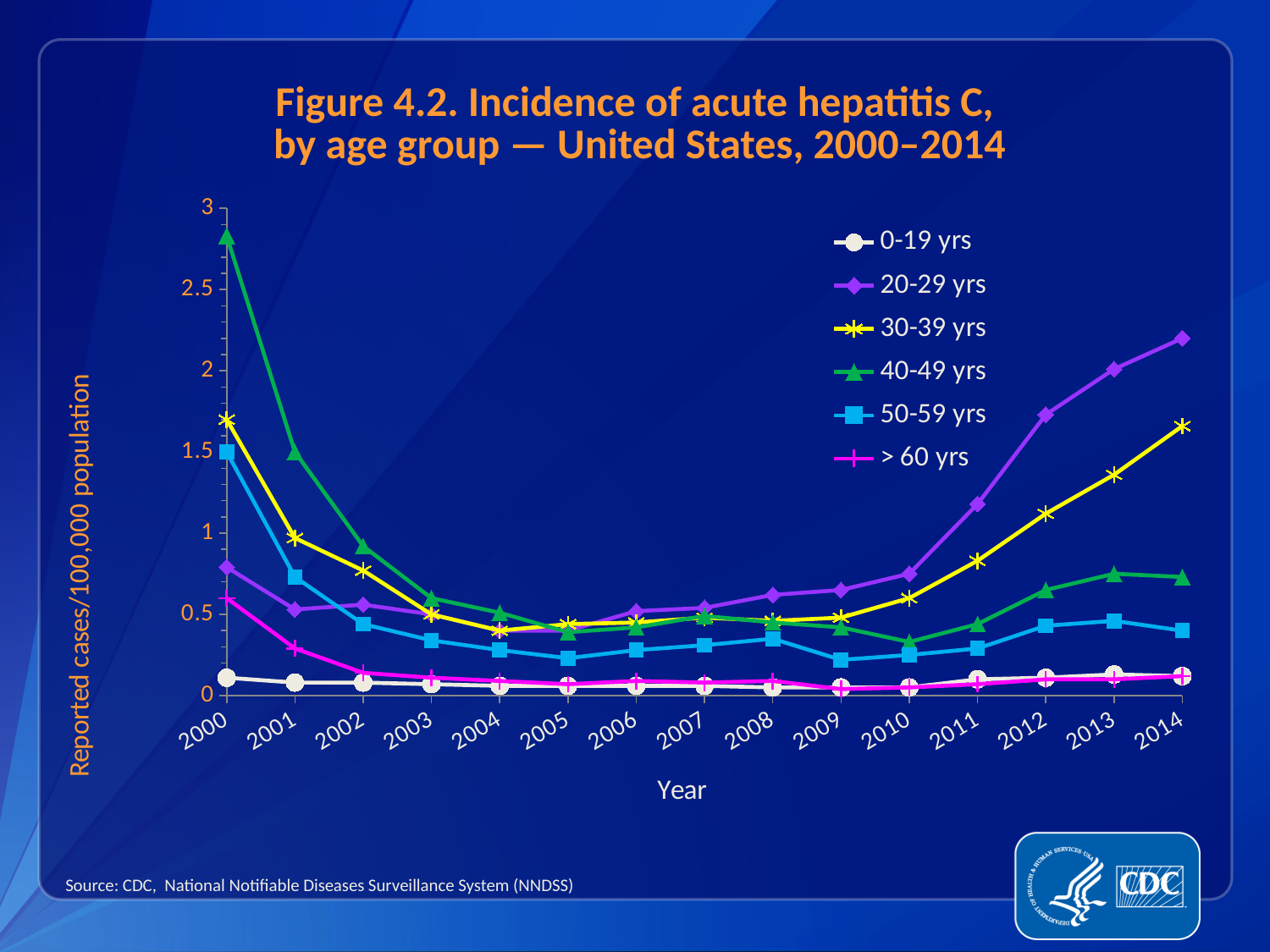
How many age groups does the legend list? 6 In 2014, which is larger: the value for 20-29 yrs or the value for 30-39 yrs? 20-29 yrs Is the value for 20-29 yrs in 2014 greater or less than 2? greater Which age group had the highest incidence in 2000? 40-49 yrs Is the value for 30-39 yrs in 2014 greater or less than 1.5? greater What kind of chart is shown on the slide? line chart Is the value for 40-49 yrs in 2000 greater or less than 2.5? greater What is the label on the y axis? Reported cases/100,000 population How many years are plotted along the x axis? 15 Does the incidence for 20-29 yrs rise or fall from 2010 to 2014? rise Which age group had the lowest incidence in 2000? 0-19 yrs Which age group had the highest incidence in 2014? 20-29 yrs